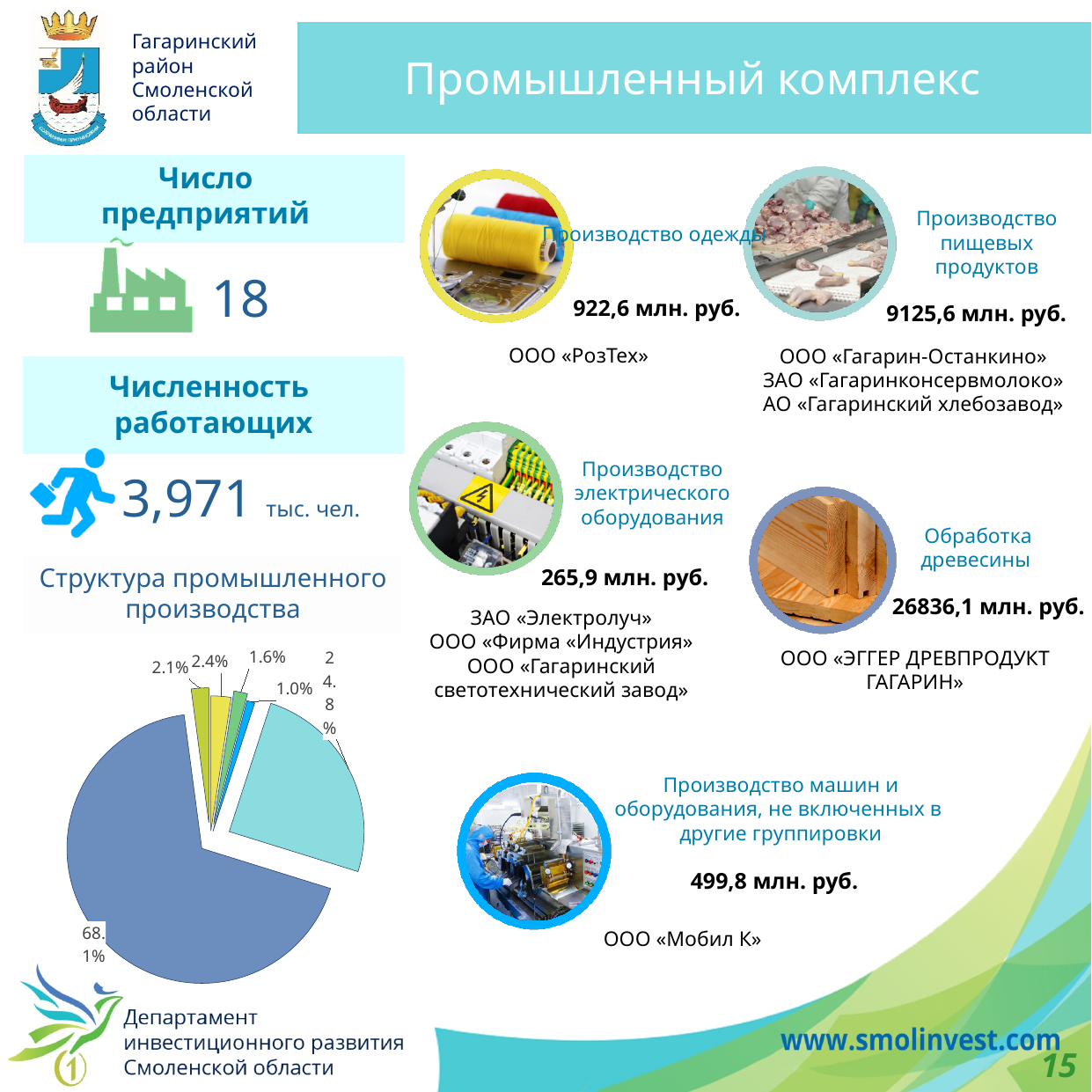
What is the value of the second-largest slice in the pie chart? 24.8% What is the difference between the 2.4% slice and the 2.1% slice in the pie chart? 0.3% What is the difference between the largest slice (68.1%) and the second-largest slice (24.8%) in the pie chart? 43.3% What is the value of the largest slice in the pie chart? 68.1% What colour is the largest slice (68.1%) of the pie chart? blue How many slices does the pie chart have? 6 What is the title of the pie chart on the slide? Структура промышленного производства Is the largest slice of the pie chart greater or less than 50%? greater What kind of chart is shown under the heading "Структура промышленного производства"? pie chart How many slices in the pie chart are smaller than 5%? 4 What is the value of the smallest slice in the pie chart? 1.0% Which is larger in the pie chart: the 2.4% slice or the 1.6% slice? 2.4%